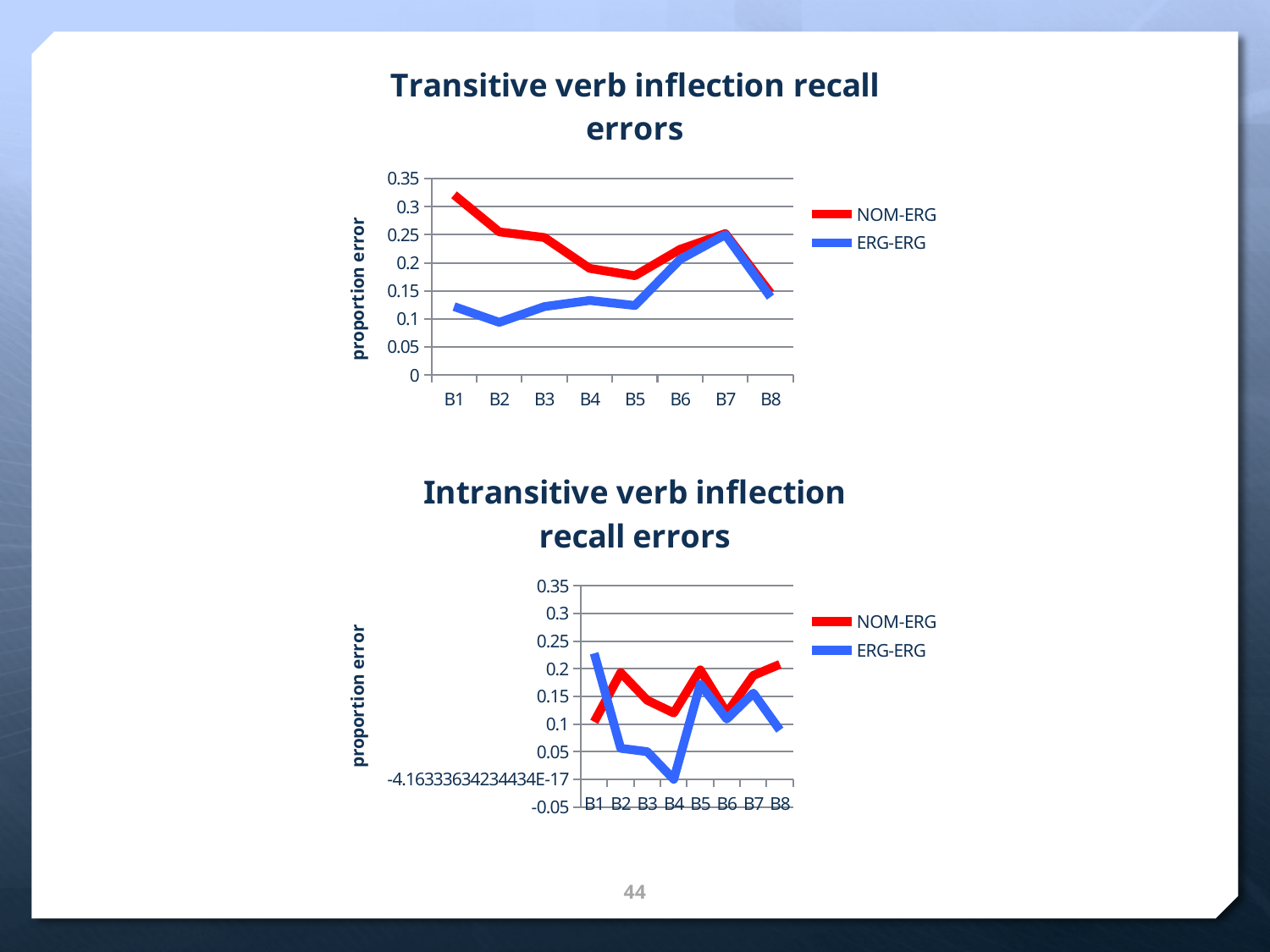
In the 'Intransitive verb inflection recall errors' chart, at which category is the ERG-ERG series lowest? B4 In the 'Transitive verb inflection recall errors' chart, is the ERG-ERG value at B7 greater or less than 0.2? greater In the 'Transitive verb inflection recall errors' chart, at which category is the NOM-ERG series highest? B1 In the 'Transitive verb inflection recall errors' chart, which series has the higher value at B3? NOM-ERG How many categories are shown on the x axis of the 'Transitive verb inflection recall errors' chart? 8 In the 'Intransitive verb inflection recall errors' chart, is the ERG-ERG value at B1 greater or less than 0.2? greater What is the y-axis label of the 'Intransitive verb inflection recall errors' chart? proportion error In the 'Transitive verb inflection recall errors' chart, at which category is the ERG-ERG series lowest? B2 What kind of chart is the 'Transitive verb inflection recall errors' chart? line chart In the 'Transitive verb inflection recall errors' chart, is the NOM-ERG value at B1 greater or less than 0.3? greater In the 'Intransitive verb inflection recall errors' chart, which series has the higher value at B2? NOM-ERG How many series does the legend of the 'Transitive verb inflection recall errors' chart list? 2